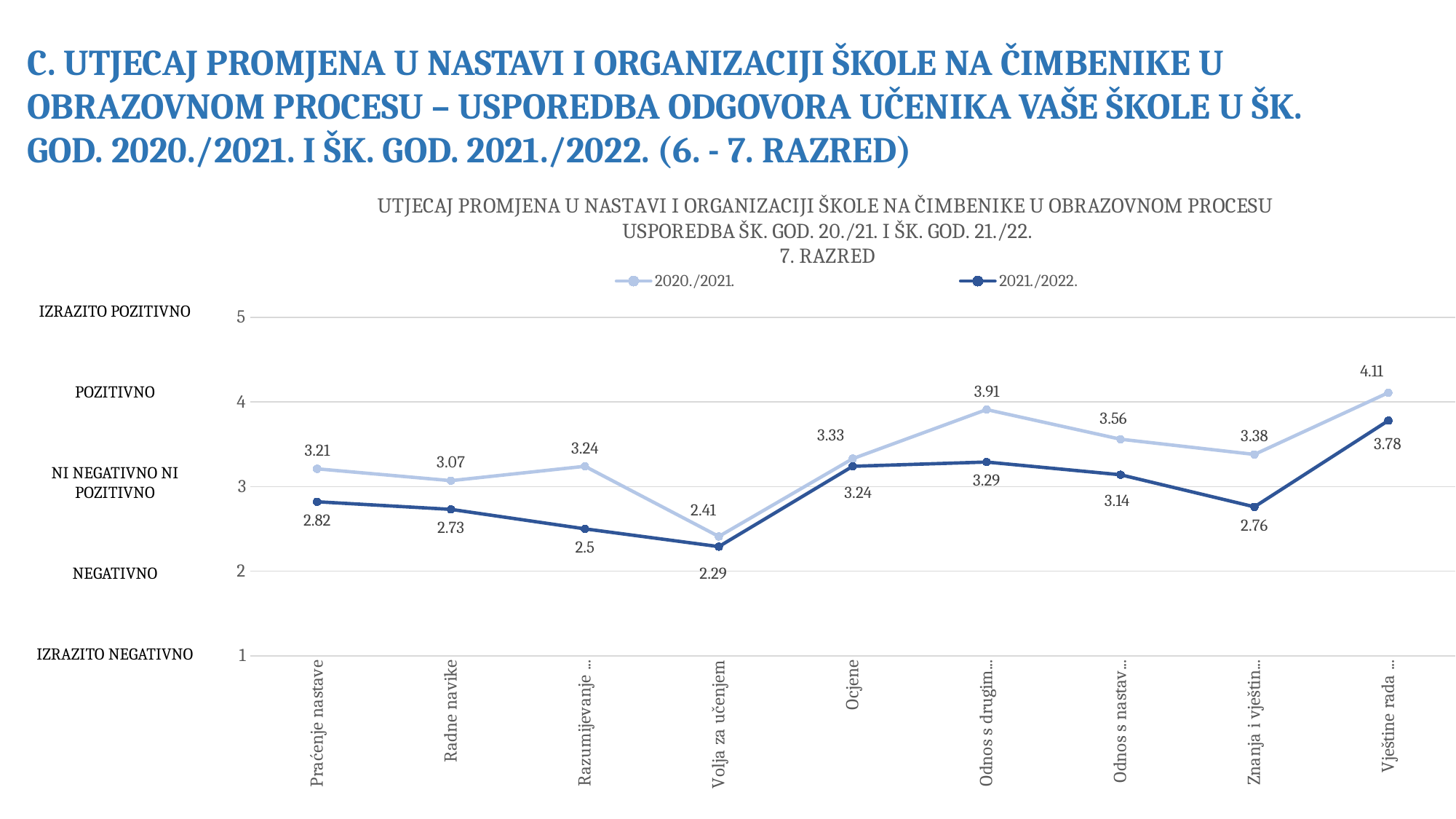
What is the difference between the 2020./2021. and 2021./2022. values for Praćenje nastave? 0.39 Which category has the lowest value in the 2021./2022. series? Volja za učenjem For Ocjene, which series has the higher value, 2020./2021. or 2021./2022.? 2020./2021. How many categories are plotted on the x axis? 9 How many series does the legend list? 2 What is the 2020./2021. value for Radne navike? 3.07 What is the 2020./2021. value for Praćenje nastave? 3.21 What kind of chart is shown on the slide? line chart What is the 2021./2022. value for Volja za učenjem? 2.29 What is the 2021./2022. value for Ocjene? 3.24 What is the highest value in the 2020./2021. series? 4.11 Is the 2020./2021. value for Volja za učenjem greater or less than 3? less